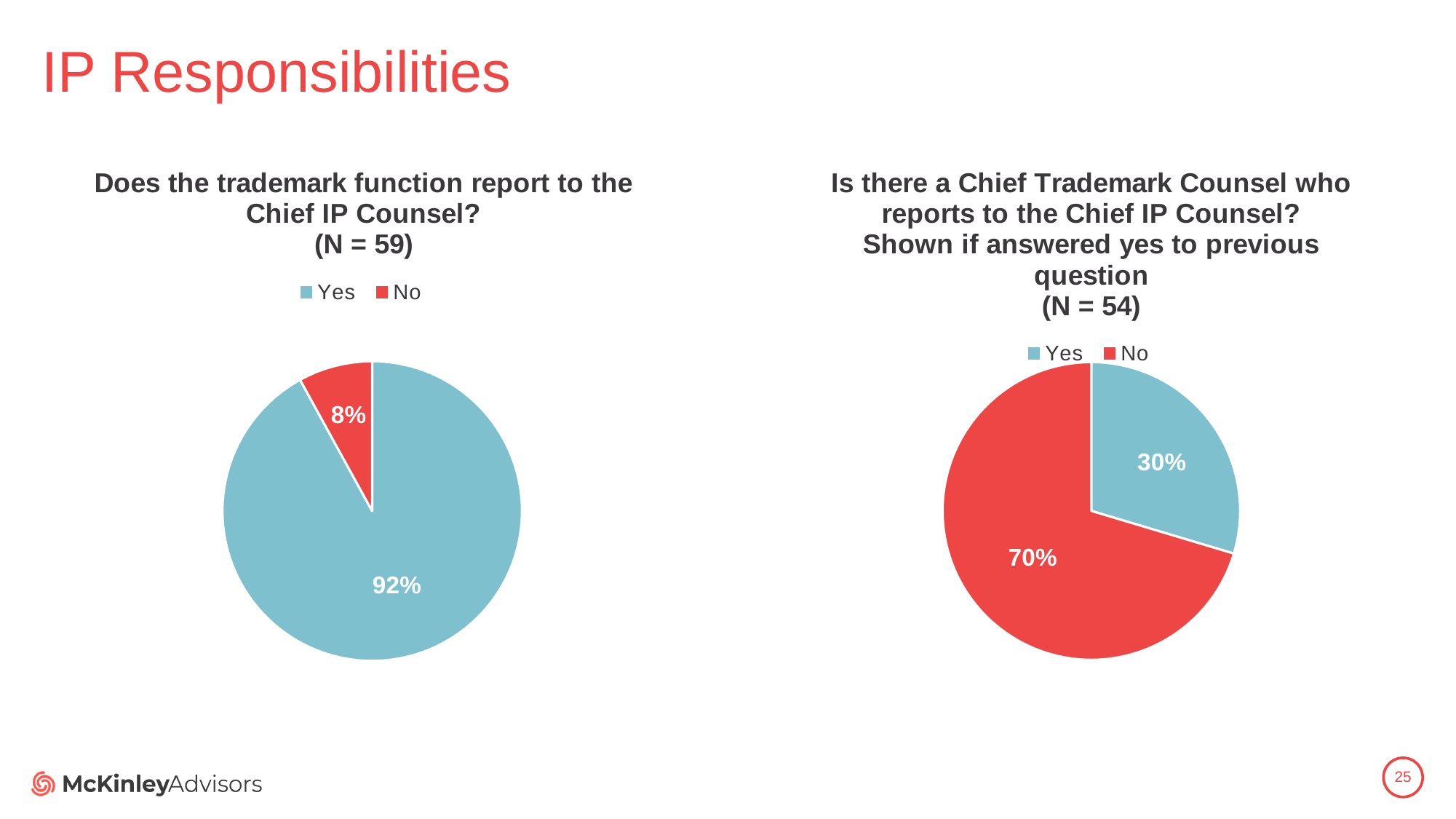
In the left pie chart (Does the trademark function report to the Chief IP Counsel?), what share of respondents answered Yes? 92% In the right pie chart, what is the difference in percentage points between the No and Yes shares? 40 percentage points How many slices does the right pie chart have? 2 In the left pie chart, which response has the larger share, Yes or No? Yes What is the sample size (N) shown in the title of the right pie chart? N = 54 In the left pie chart (Does the trademark function report to the Chief IP Counsel?), what share of respondents answered No? 8% In the right pie chart, which response has the larger share, Yes or No? No In the left pie chart, what is the difference in percentage points between the Yes and No shares? 84 percentage points In the right pie chart (Is there a Chief Trademark Counsel who reports to the Chief IP Counsel?), what share of respondents answered No? 70% What type of chart is used on the left side of the slide? Pie chart How many entries does the legend of the left pie chart list? 2 In the right pie chart (Is there a Chief Trademark Counsel who reports to the Chief IP Counsel?), what share of respondents answered Yes? 30%